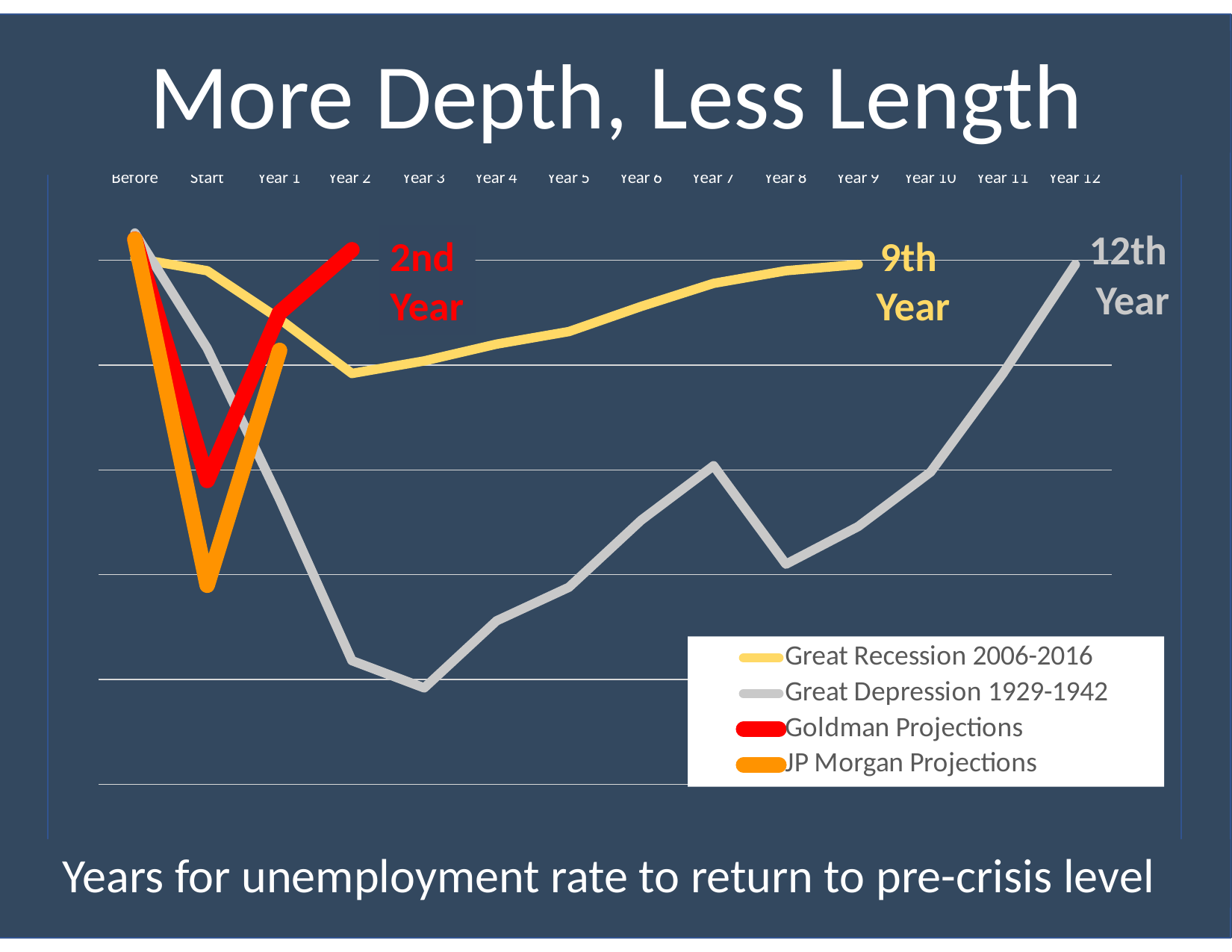
According to the annotation, in which year does the Great Recession 2006-2016 line return to the pre-crisis level? 9th Year According to the annotation, in which year does the Great Depression 1929-1942 line return to the pre-crisis level? 12th Year Which series reaches the lowest point on the chart? Great Depression 1929-1942 According to the annotation, in which year do the Goldman Projections return to the pre-crisis level? 2nd Year What is the title of the slide above the chart? More Depth, Less Length Does the Great Depression 1929-1942 line rise or fall from Year 3 to Year 7? rise How many series does the legend list? 4 What kind of chart is shown on the slide? line chart At the Start category, which line dips lower: Goldman Projections or JP Morgan Projections? JP Morgan Projections Which series is drawn in orange according to the legend? JP Morgan Projections Does the Great Recession 2006-2016 line rise or fall from Year 2 to Year 9? rise How many categories are shown along the x axis? 14